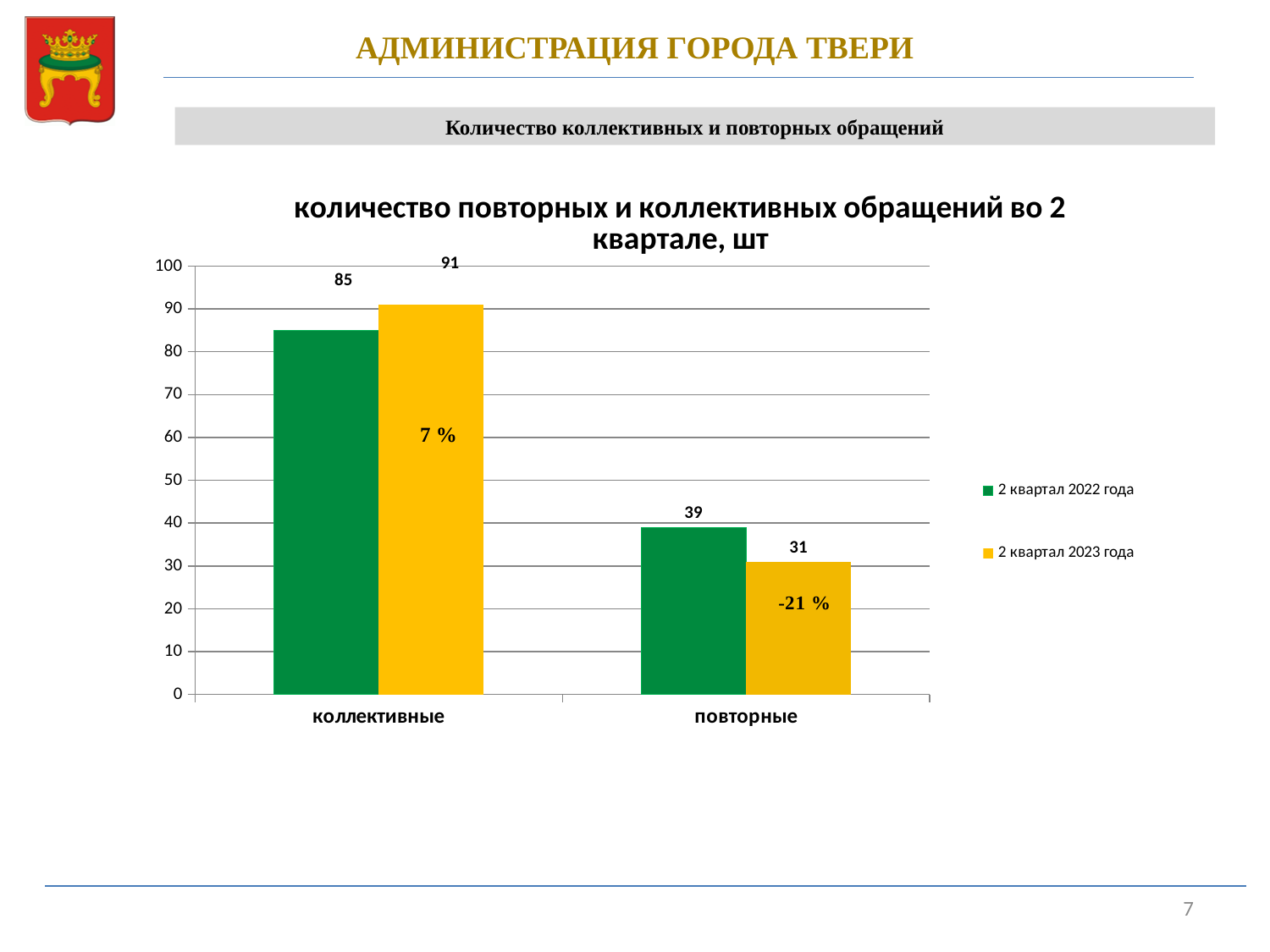
How many categories are shown on the x axis? 2 What is the value for коллективные in 2 квартал 2023 года? 91 Which category has the lowest value in 2 квартал 2022 года? повторные How many series does the legend list? 2 What is the value for повторные in 2 квартал 2023 года? 31 What is the difference between the 2 квартал 2023 года and 2 квартал 2022 года values for коллективные? 6 Which category has the highest value in 2 квартал 2023 года? коллективные Which is larger for повторные: the 2 квартал 2022 года value or the 2 квартал 2023 года value? 2 квартал 2022 года What is the value for повторные in 2 квартал 2022 года? 39 What is the value for коллективные in 2 квартал 2022 года? 85 What is the difference between the 2 квартал 2022 года and 2 квартал 2023 года values for повторные? 8 What kind of chart is shown on the slide? bar chart